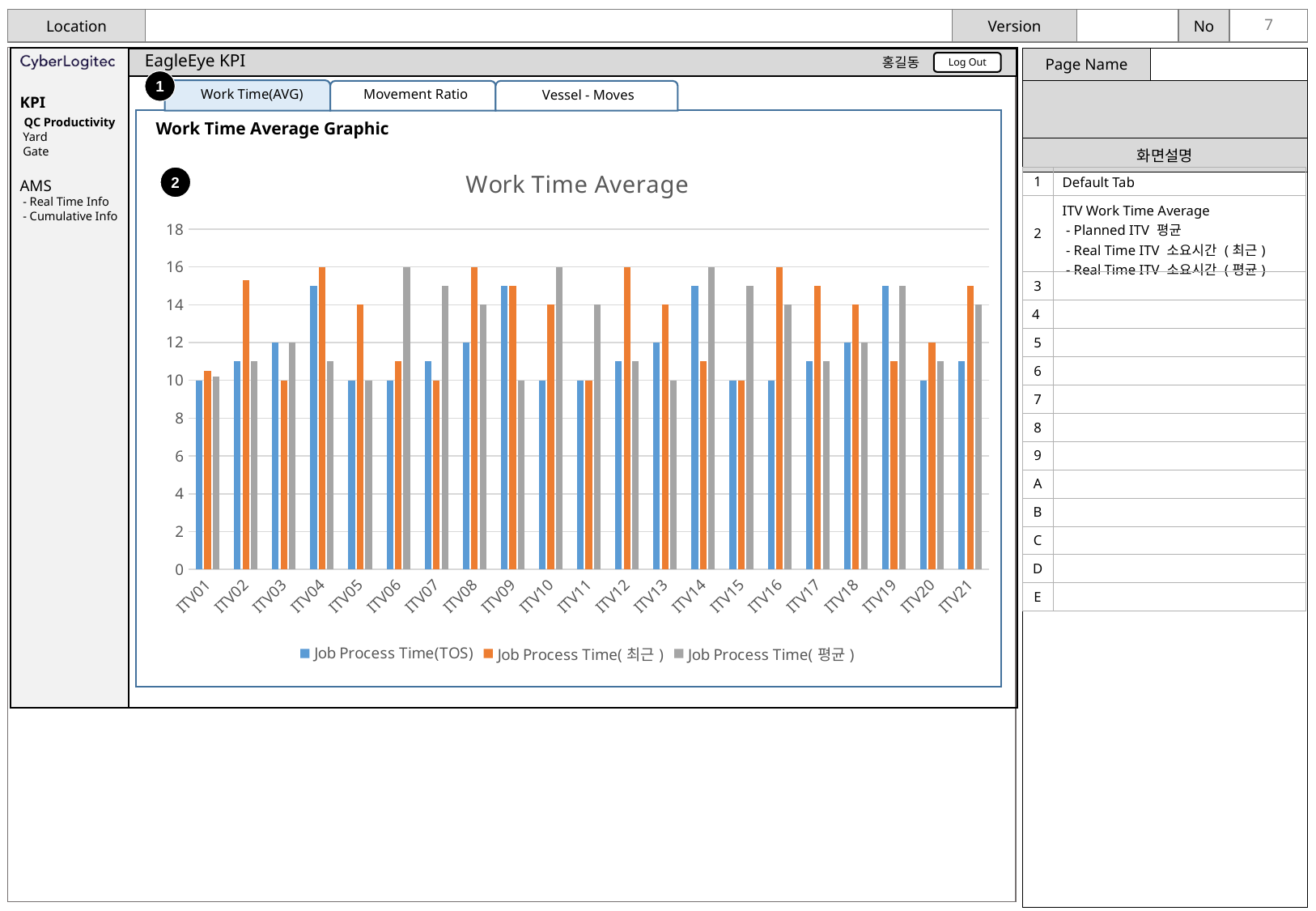
What kind of chart is shown under the title "Work Time Average"? bar chart What is the Job Process Time( 최근 ) value for ITV04? 16 How many ITV categories are shown on the x axis of the Work Time Average chart? 21 Is the Job Process Time( 최근 ) value for ITV02 greater or less than 14? greater What is the Job Process Time( 평균 ) value for ITV06? 16 Is the Job Process Time( 최근 ) value for ITV01 greater or less than 12? less What is the Job Process Time(TOS) value for ITV01? 10 What is the Job Process Time( 최근 ) value for ITV20? 12 What is the title of the chart? Work Time Average For ITV12, which is larger: Job Process Time(TOS) or Job Process Time( 최근 )? Job Process Time( 최근 ) Which series is shown in blue in the Work Time Average chart? Job Process Time(TOS) How many series does the legend of the Work Time Average chart list? 3